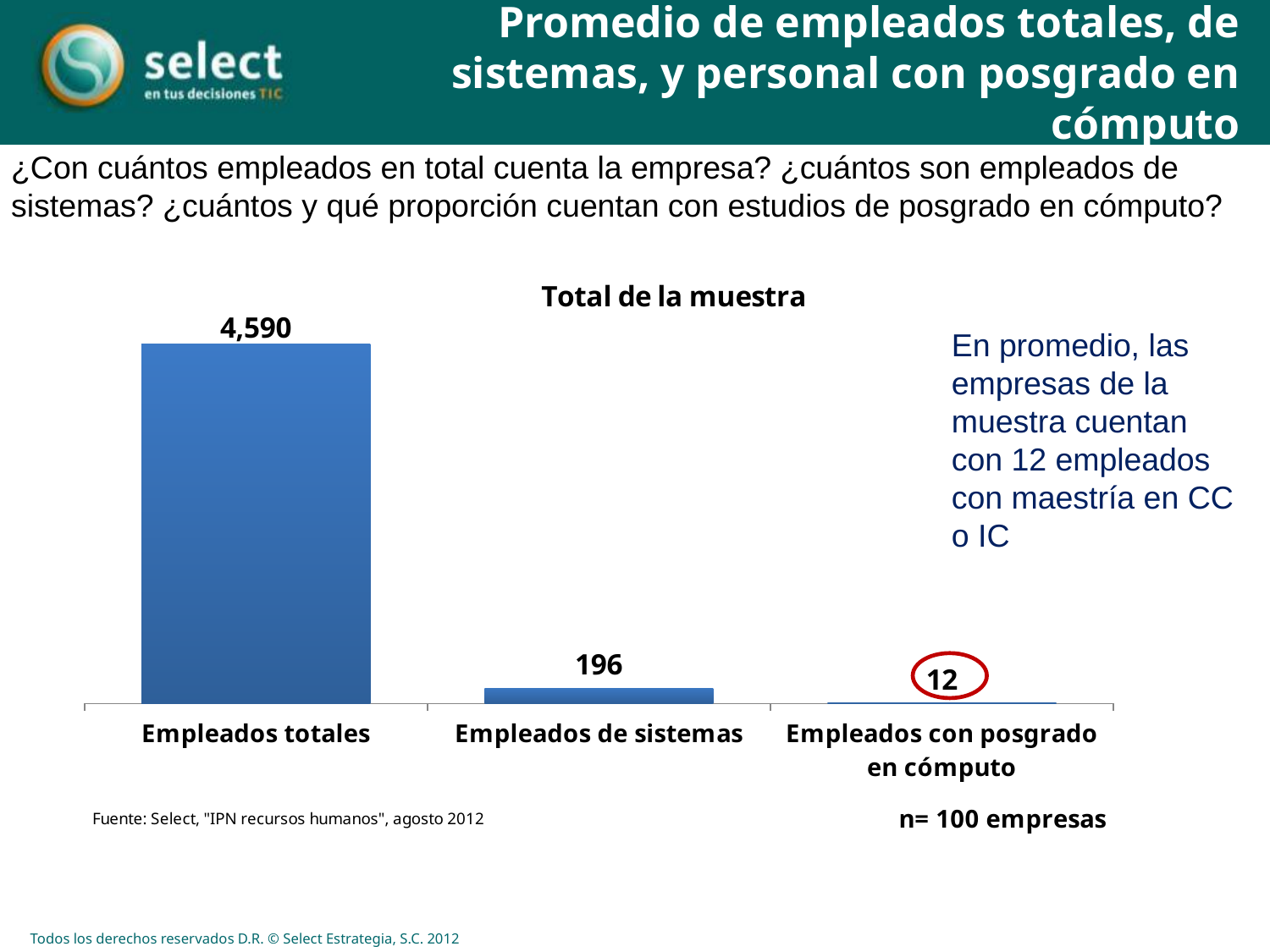
Which category has the highest value? Empleados totales How many categories are shown in the chart? 3 Do the values rise or fall from left to right across the categories? Fall Which category has the lowest value? Empleados con posgrado en cómputo What is the title of the chart? Total de la muestra Which is larger, Empleados de sistemas or Empleados con posgrado en cómputo? Empleados de sistemas What is the value for Empleados totales? 4,590 What kind of chart is shown on the slide? Bar chart What is the difference between Empleados totales and Empleados de sistemas? 4,394 What is the value for Empleados con posgrado en cómputo? 12 What is the value for Empleados de sistemas? 196 What is the difference between Empleados de sistemas and Empleados con posgrado en cómputo? 184